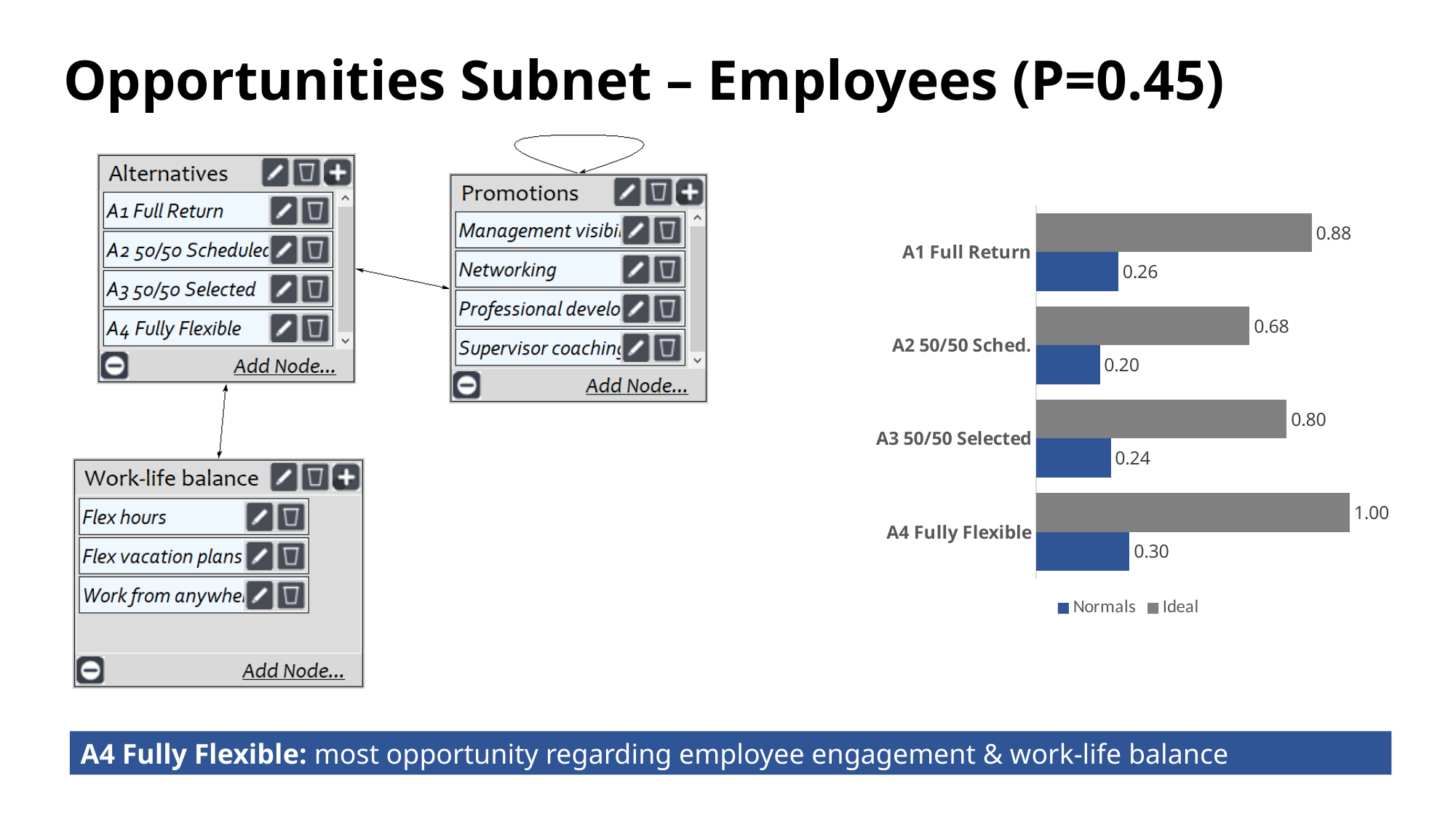
What is the Ideal value for A2 50/50 Sched.? 0.68 What kind of chart is shown on the slide? Bar chart How many alternatives are shown on the chart? 4 What is the Ideal value for A4 Fully Flexible? 1.00 Which alternative has the highest Normals value? A4 Fully Flexible How many series does the chart legend list? 2 What is the Normals value for A3 50/50 Selected? 0.24 Which alternative has the lowest Ideal value? A2 50/50 Sched. What is the difference between the Ideal values for A4 Fully Flexible and A1 Full Return? 0.12 What is the Normals value for A1 Full Return? 0.26 Which colour represents the Ideal series in the chart? Grey Which is larger, the Normals value for A1 Full Return or for A3 50/50 Selected? A1 Full Return